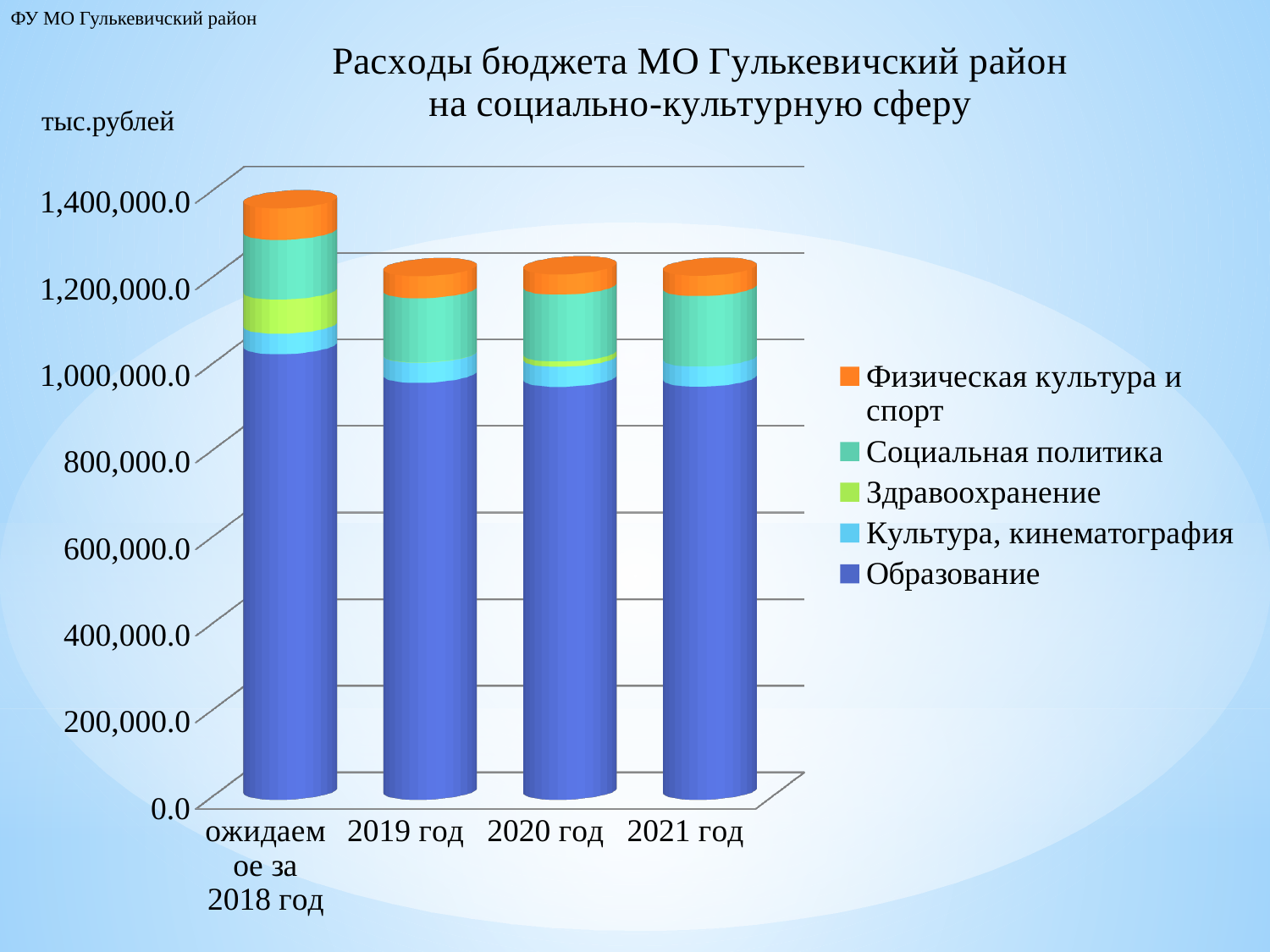
How many series does the chart's legend list? 5 What kind of chart is shown on the slide? Stacked bar chart Which category has the highest total bar? ожидаемое за 2018 год Is the total bar for ожидаемое за 2018 год greater or less than 1,200,000.0? greater Is the Образование segment for 2020 год greater or less than 800,000.0? greater Which series is shown at the bottom of each stacked bar? Образование Which category has the largest Здравоохранение segment? ожидаемое за 2018 год Which total bar is larger, ожидаемое за 2018 год or 2019 год? ожидаемое за 2018 год What unit is indicated for the values on the chart's vertical axis? тыс.рублей How many categories are shown along the x axis of the chart? 4 Does the total bar rise or fall from ожидаемое за 2018 год to 2019 год? Fall Is the total bar for 2021 год greater or less than 1,000,000.0? greater